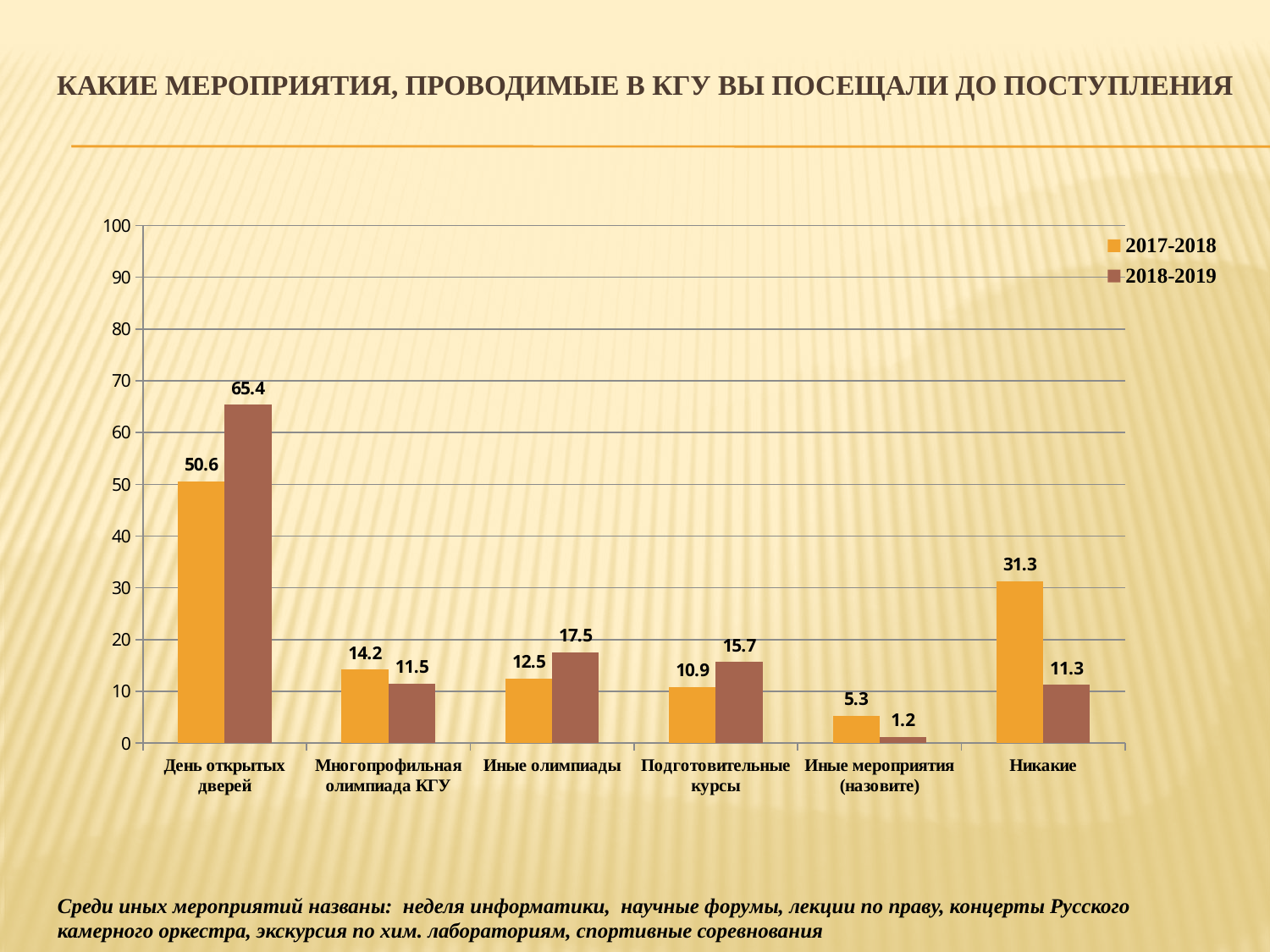
What is the difference between the 2017-2018 and 2018-2019 values for Никакие? 20 For Иные олимпиады, which series has the larger value, 2017-2018 or 2018-2019? 2018-2019 Which category has the highest value in the 2017-2018 series? День открытых дверей What is the difference between the 2018-2019 and 2017-2018 values for День открытых дверей? 14.8 How many series does the legend list? 2 What kind of chart is shown on the slide? Bar chart How many categories are shown on the x axis? 6 For Многопрофильная олимпиада КГУ, which series has the larger value, 2017-2018 or 2018-2019? 2017-2018 What is the value for Никакие in the 2017-2018 series? 31.3 What is the value for День открытых дверей in the 2018-2019 series? 65.4 Which category has the lowest value in the 2018-2019 series? Иные мероприятия (назовите) What is the value for Подготовительные курсы in the 2018-2019 series? 15.7